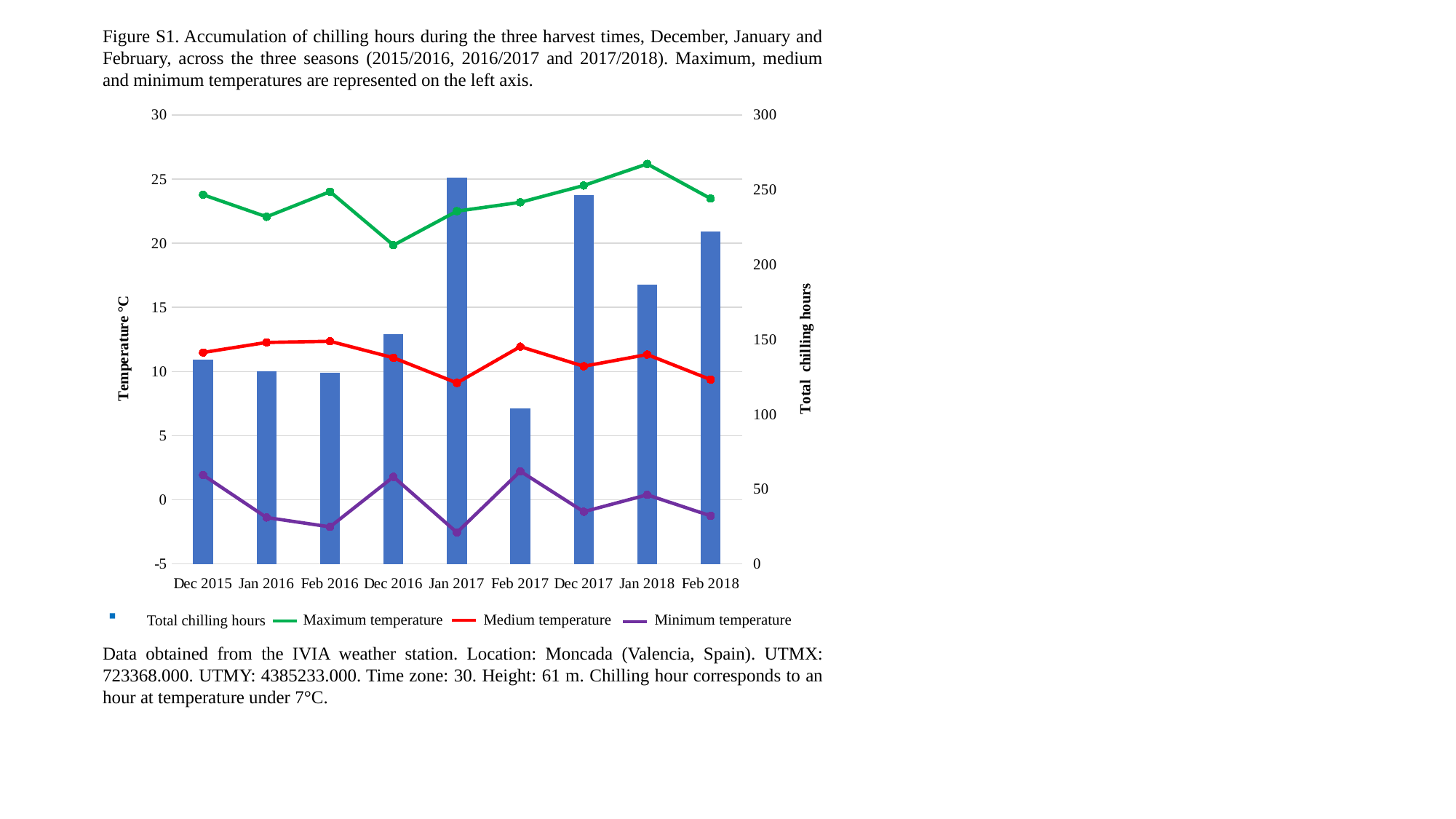
How many series does the legend list? 4 Are the total chilling hours for Dec 2017 greater or less than 200? greater Which month has the lowest total chilling hours? Feb 2017 Which month has the highest maximum temperature? Jan 2018 Are the total chilling hours for Feb 2017 greater or less than 150? less What is the title of the right-hand vertical axis? Total chilling hours Which month has the highest total chilling hours? Jan 2017 Is the maximum temperature for Jan 2018 greater or less than 25? greater Which month has the lowest maximum temperature? Dec 2016 How many months are shown on the x axis? 9 Which has more total chilling hours, Dec 2017 or Jan 2018? Dec 2017